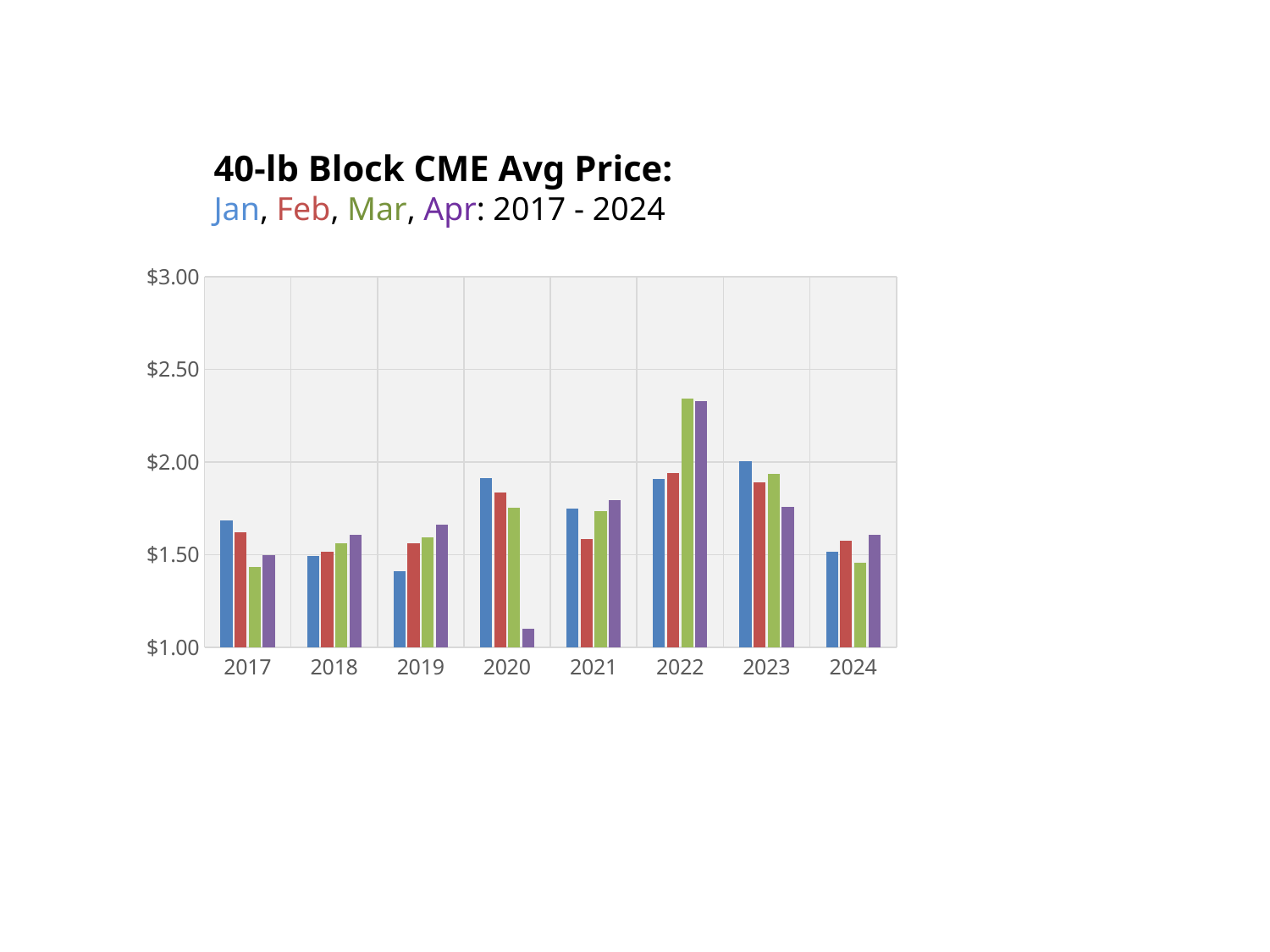
Is the Jan value for 2019 greater or less than $1.50? less How many years are shown along the x axis of the chart? 8 What kind of chart is shown on the slide? bar chart Is the Mar value for 2022 greater or less than $2.00? greater Do the values for 2019 rise or fall from Jan to Apr? rise Is the Apr value for 2020 greater or less than $1.50? less In which year is the Apr value the lowest? 2020 Which is larger in 2020, the Jan value or the Apr value? Jan Which month is shown in purple in the chart? Apr In which year is the Mar value the highest? 2022 How many series (months) does the chart plot for each year? 4